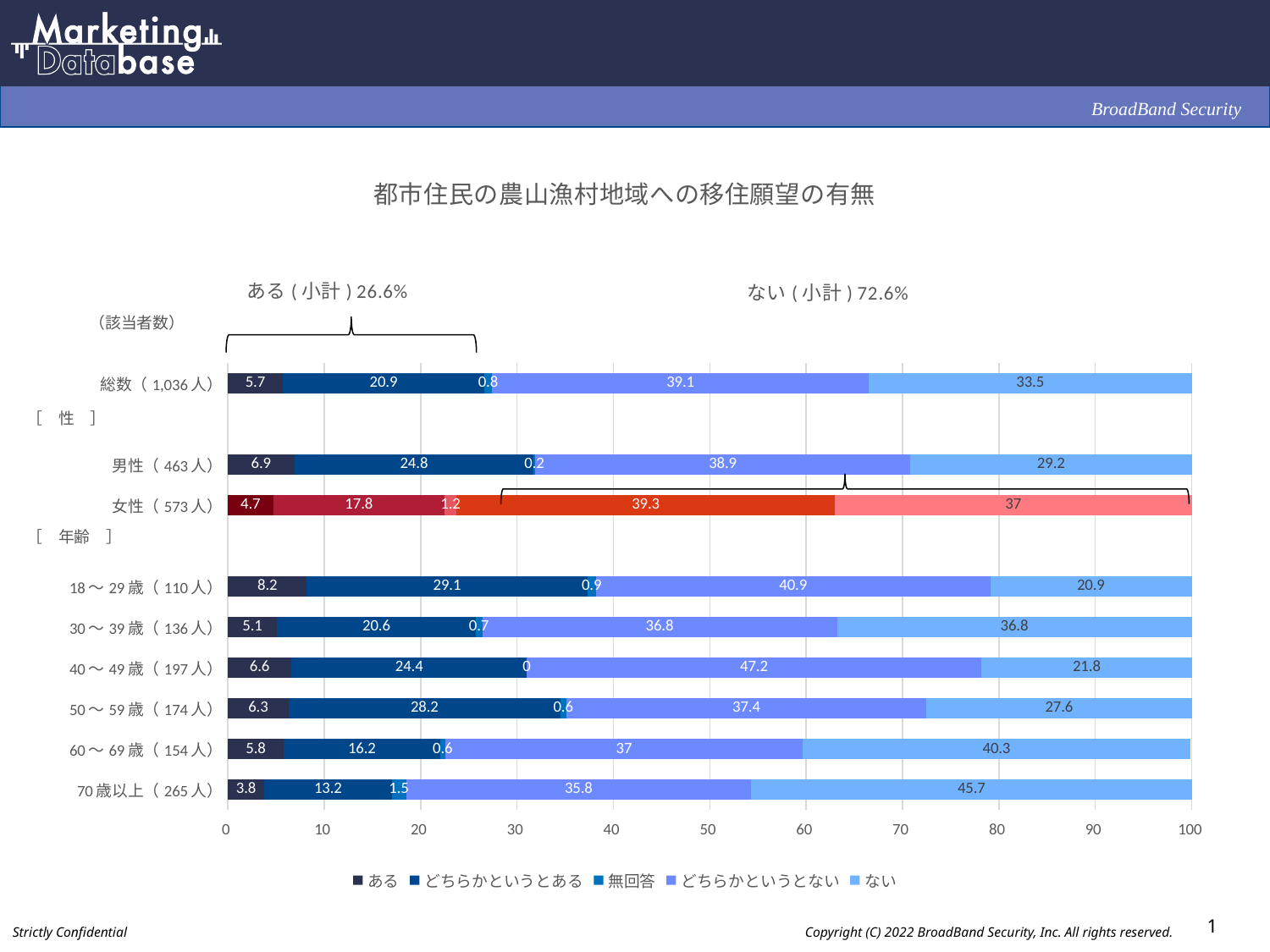
What is the difference between the ない values for 60～69歳 (154人) and 18～29歳 (110人)? 19.4 Which category has the highest value for ない? 70歳以上 (265人) What is the ある (小計) percentage shown above the chart? 26.6% What is the title of the chart? 都市住民の農山漁村地域への移住願望の有無 What is the value of ない for 総数 (1,036人)? 33.5 What type of chart is shown on the slide? Stacked bar chart How many category bars are plotted in the chart? 9 Which is larger, the どちらかというとある value for 50～59歳 (174人) or for 60～69歳 (154人)? 50～59歳 (174人) What is the value of どちらかというとある for 男性 (463人)? 24.8 What is the value of どちらかというとない for 40～49歳 (197人)? 47.2 How many series does the legend list? 5 Which category has the lowest value for ある? 70歳以上 (265人)